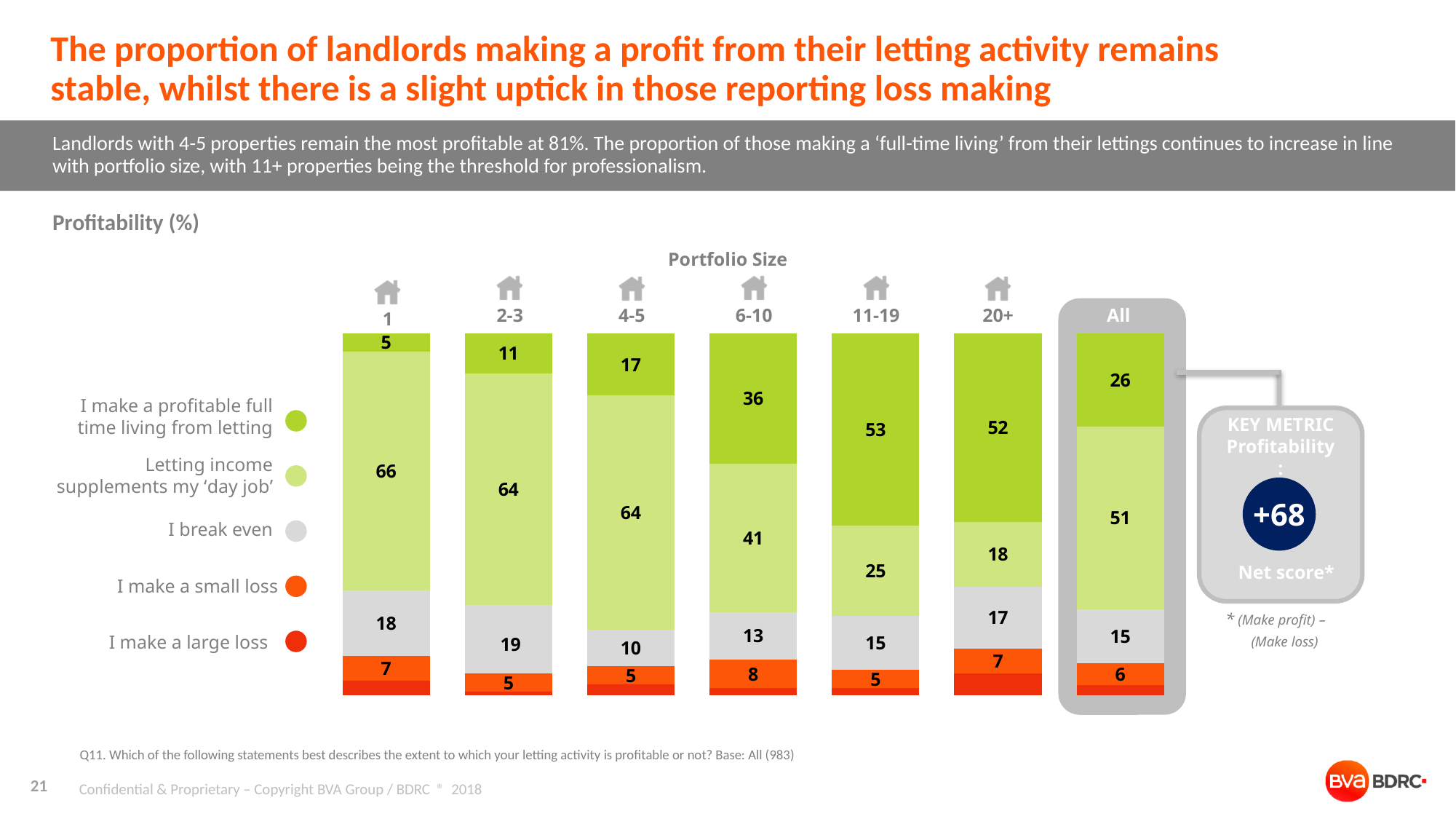
How much higher is the 'profitable full time living' value for All landlords than for landlords with 1 property? 21 Which has a larger 'Letting income supplements my day job' value: landlords with 2-3 properties or 6-10 properties? 2-3 What kind of chart is used to show Profitability (%)? Stacked bar chart How many response categories does the legend list? 5 What is the 'I make a small loss' value for landlords with 6-10 properties? 8 What is the Key Metric Profitability net score shown on the slide? +68 Which portfolio size has the lowest proportion making a profitable full time living from letting? 1 How many portfolio size categories (including All) are shown in the chart? 7 What is the 'I break even' value for landlords with 20+ properties? 17 Which portfolio size has the highest proportion making a profitable full time living from letting? 11-19 What percentage of landlords with 11-19 properties say they make a profitable full time living from letting? 53 What percentage of landlords with 1 property say letting income supplements their 'day job'? 66